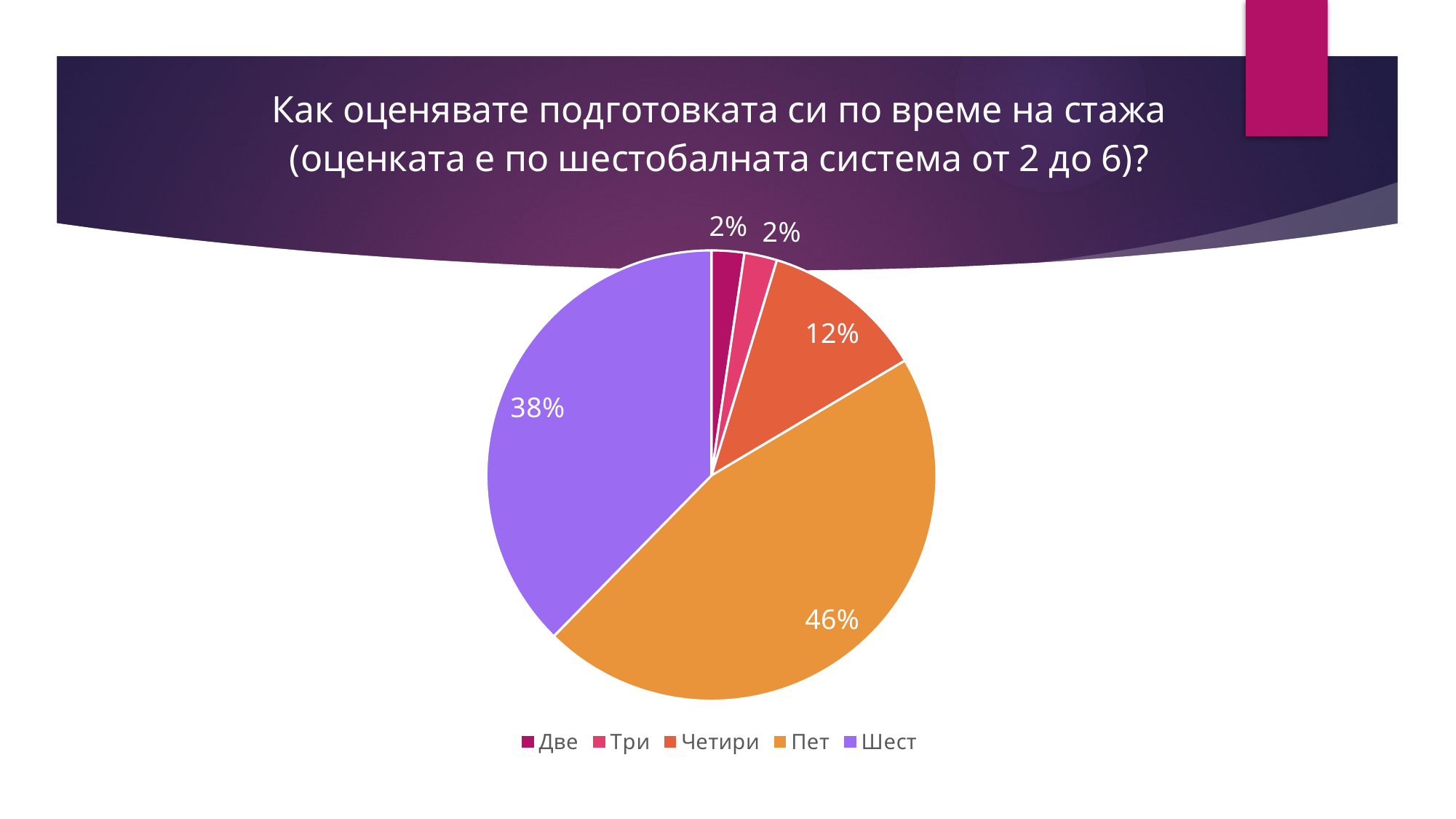
What is the value shown for "Четири"? 12% What is the value shown for "Две"? 2% What share of the pie does the "Пет" slice represent? 46% What share of the pie does the "Шест" slice represent? 38% What is the difference between the values for "Шест" and "Четири"? 26% Which category has the largest slice of the pie? Пет What colour is the "Шест" slice? purple What is the difference between the values for "Пет" and "Шест"? 8% How many categories does the legend list? 5 Which is larger, the slice for "Четири" or the slice for "Шест"? Шест What kind of chart is shown on the slide? pie chart What is the value shown for "Три"? 2%